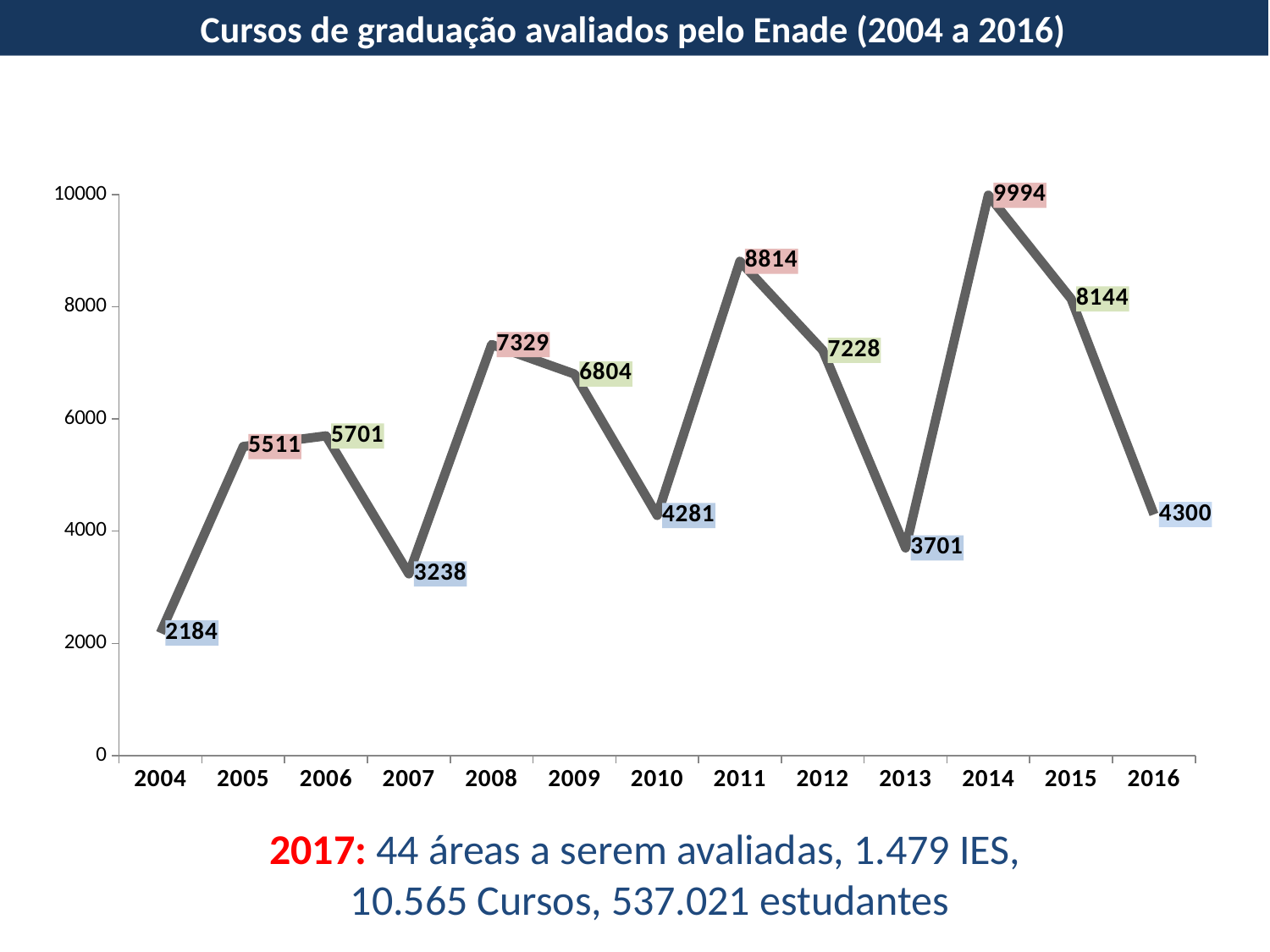
Which year has the lowest value? 2004 What kind of chart is shown? line chart Is the value for 2012 greater or less than 6000? greater What is the value for 2011? 8814 Which year has the highest value? 2014 Does the value rise or fall from 2015 to 2016? fall What is the difference between the values for 2014 and 2013? 6293 What is the title of the chart? Cursos de graduação avaliados pelo Enade (2004 a 2016) Which is larger, the value for 2008 or the value for 2009? 2008 What is the value for 2004? 2184 How many years are plotted on the chart? 13 What is the value for 2016? 4300